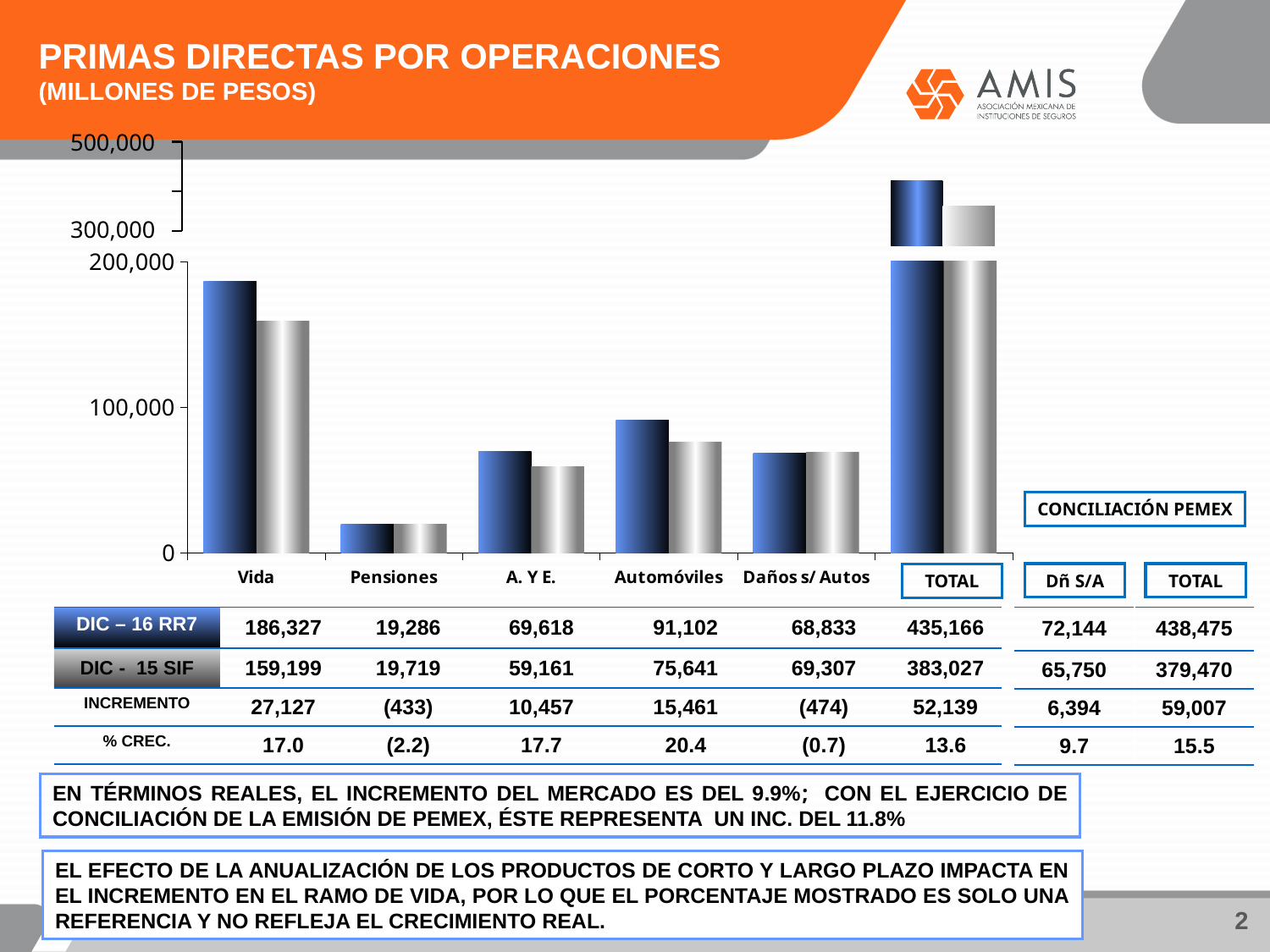
What is the DIC – 16 RR7 value for Vida? 186,327 How many categories are shown on the x axis of the chart? 6 What is the difference between the DIC – 16 RR7 and DIC - 15 SIF values for A. Y E.? 10,457 Excluding TOTAL, which category has the highest DIC – 16 RR7 value? Vida How many data series are plotted in the chart? 2 What is the DIC – 16 RR7 value for Pensiones? 19,286 What is the title of the chart? PRIMAS DIRECTAS POR OPERACIONES (MILLONES DE PESOS) Which is larger for Daños s/Autos: the DIC – 16 RR7 value or the DIC - 15 SIF value? DIC - 15 SIF Excluding TOTAL, which category has the lowest DIC - 15 SIF value? Pensiones Is the DIC – 16 RR7 value for Automóviles greater or less than 100,000? less What type of chart is shown on the slide? bar chart What is the DIC - 15 SIF value for Automóviles? 75,641